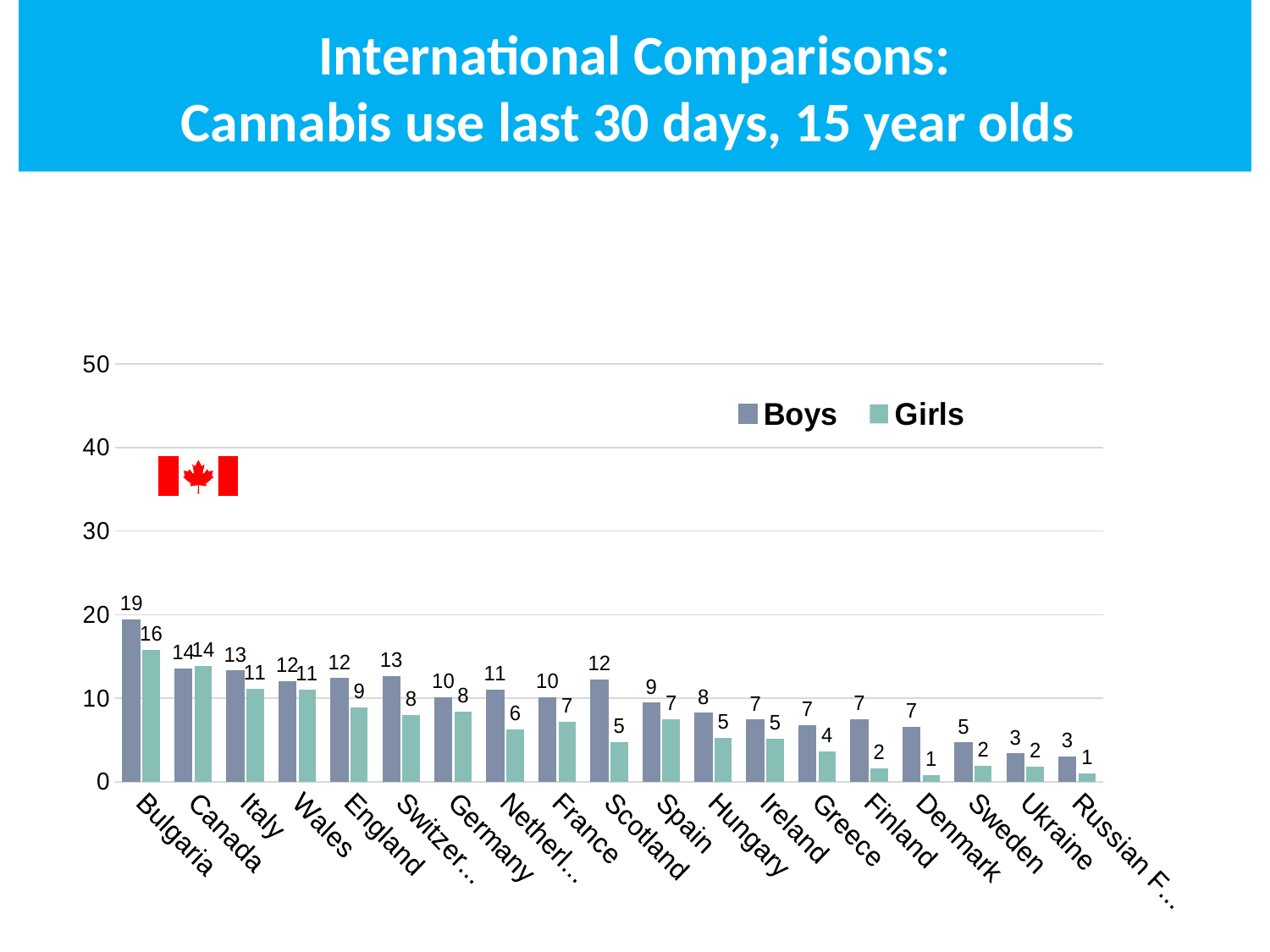
What kind of chart is shown on the slide? Bar chart What is the value for Boys in Bulgaria? 19 What is the value for Boys in Finland? 7 Which country has the highest value for Boys? Bulgaria Which is larger, the Girls value for Italy or the Girls value for Greece? Italy What is the value for Girls in Scotland? 5 What is the value for Girls in Canada? 14 What is the difference between the Boys values for Bulgaria and Sweden? 14 What is the difference between the Boys and Girls values for England? 3 How many series does the legend list? 2 Do the Boys values generally rise or fall from left to right across the countries? Fall Which country has the highest value for Girls? Bulgaria